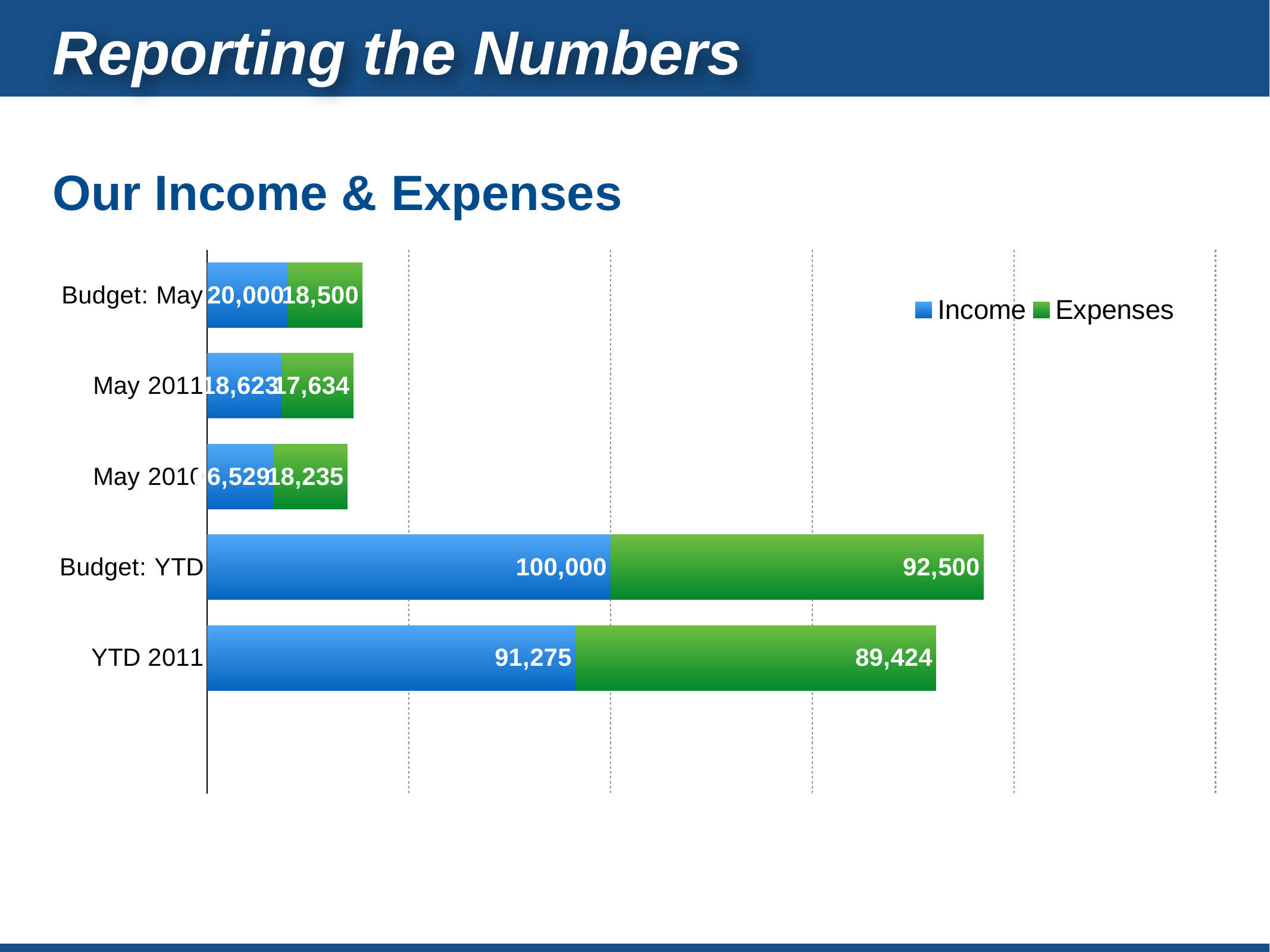
Which is larger: Expenses for Budget: YTD or Expenses for YTD 2011? Budget: YTD What is the Expenses value for May 2010? 18,235 What is the Income value for YTD 2011? 91,275 What is the difference between Income and Expenses for Budget: YTD? 7,500 What is the Income value for Budget: YTD? 100,000 What is the Expenses value for Budget: May? 18,500 What is the total of the stacked bar for YTD 2011? 180,699 What kind of chart is shown on the slide? Bar chart How many series does the legend list? 2 Which category has the highest Income value? Budget: YTD What is the Expenses value for YTD 2011? 89,424 How many categories are shown on the chart? 5